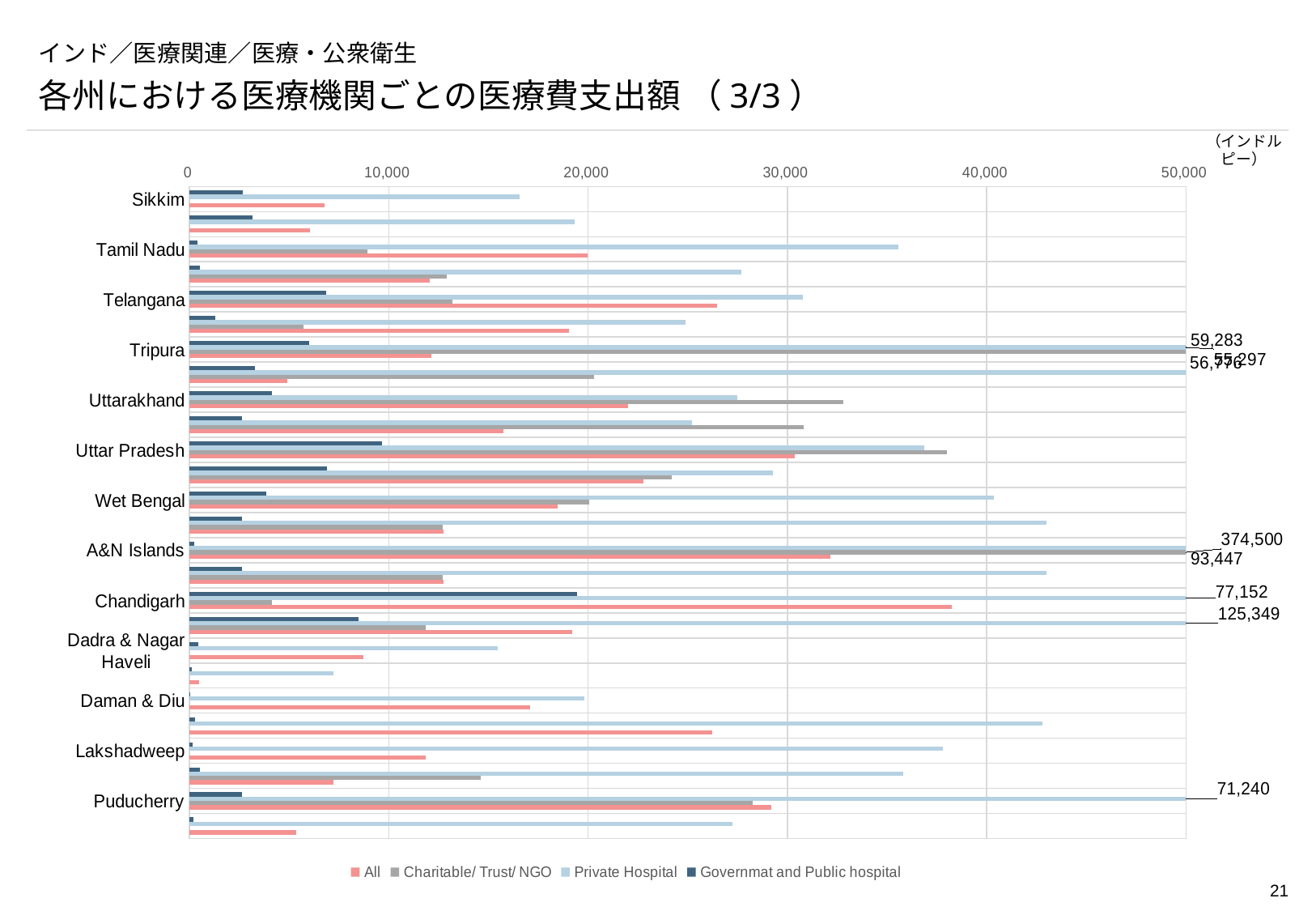
What is the difference between the two labelled values for Chandigarh, 125,349 and 77,152? 48,197 Which is larger: the labelled value for Puducherry (71,240) or the smaller labelled value for Chandigarh (77,152)? Chandigarh (77,152) Which state or territory has the bar labelled 374,500? A&N Islands Is the longest bar for Sikkim greater or less than 10,000? greater How many states or territories are listed on the vertical axis of the chart? 13 What kind of chart is shown on the slide? bar chart Is the longest Private Hospital bar for Lakshadweep greater or less than 30,000? greater What are the two data labels printed for Chandigarh? 77,152 and 125,349 How many series does the legend list? 4 What unit is indicated at the top right of the chart? インドルピー What data label is printed next to the Puducherry bar that extends beyond the axis? 71,240 What is the largest data label printed on the chart? 374,500